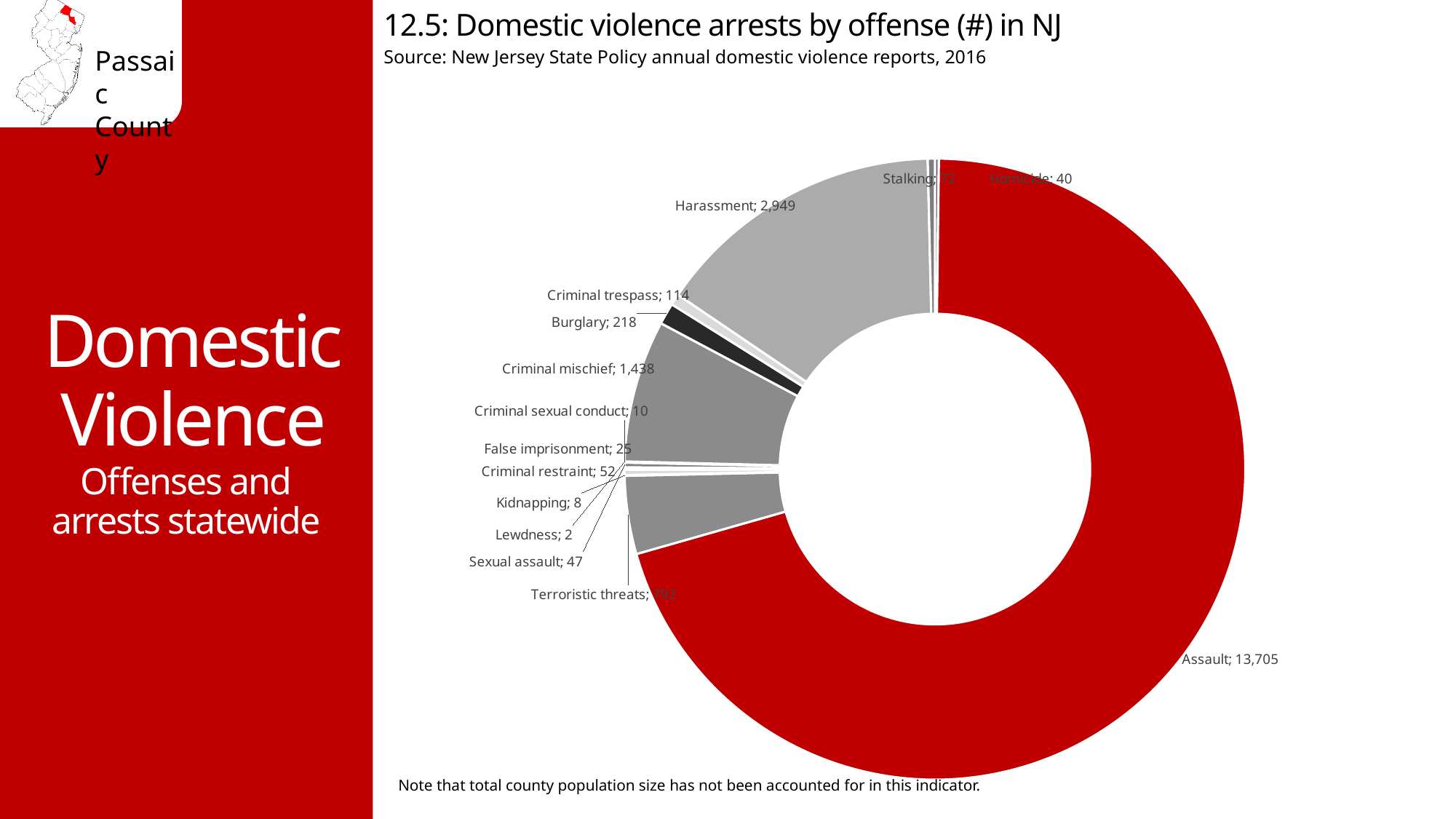
What is the title of the chart? 12.5: Domestic violence arrests by offense (#) in NJ How many domestic violence arrests were there for Burglary? 218 What kind of chart is shown on the slide? Pie (donut) chart How many domestic violence arrests were there for Harassment? 2,949 Which offense has the highest number of domestic violence arrests? Assault Which has more arrests, Criminal restraint or Sexual assault? Criminal restraint What year do the source reports for the chart come from? 2016 How many offense categories are shown in the chart? 14 How many domestic violence arrests were there for Criminal mischief? 1,438 What is the difference between the number of arrests for Burglary and for Criminal trespass? 104 Which offense has the lowest number of domestic violence arrests? Lewdness How many domestic violence arrests were there for Assault? 13,705